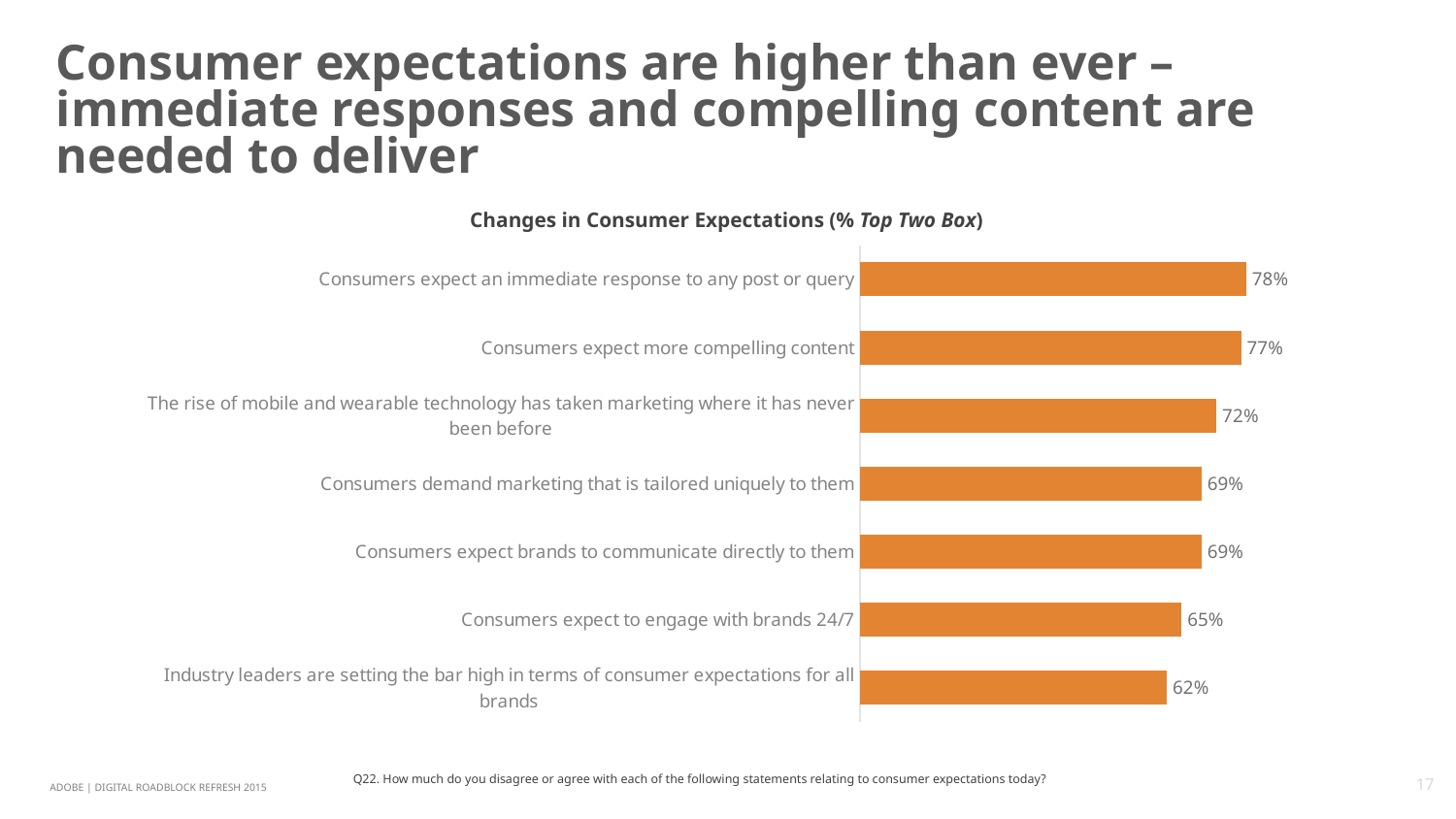
What is the difference between the values for 'Consumers expect more compelling content' and 'Consumers expect to engage with brands 24/7'? 12% What is the value for 'The rise of mobile and wearable technology has taken marketing where it has never been before'? 72% What is the title of the chart? Changes in Consumer Expectations (% Top Two Box) How many statements (bars) are shown in the chart? 7 What percentage is shown for 'Consumers expect to engage with brands 24/7'? 65% Which statement has the lowest percentage in the chart? Industry leaders are setting the bar high in terms of consumer expectations for all brands What type of chart is shown on the slide? Bar chart What is the difference between the value for 'Consumers expect an immediate response to any post or query' and the value for 'Industry leaders are setting the bar high in terms of consumer expectations for all brands'? 16% Which statement has the highest percentage in the chart? Consumers expect an immediate response to any post or query What percentage of respondents agree that consumers expect an immediate response to any post or query? 78% Which is larger: the value for 'Consumers demand marketing that is tailored uniquely to them' or the value for 'Consumers expect to engage with brands 24/7'? Consumers demand marketing that is tailored uniquely to them What is the value for 'Consumers expect more compelling content'? 77%